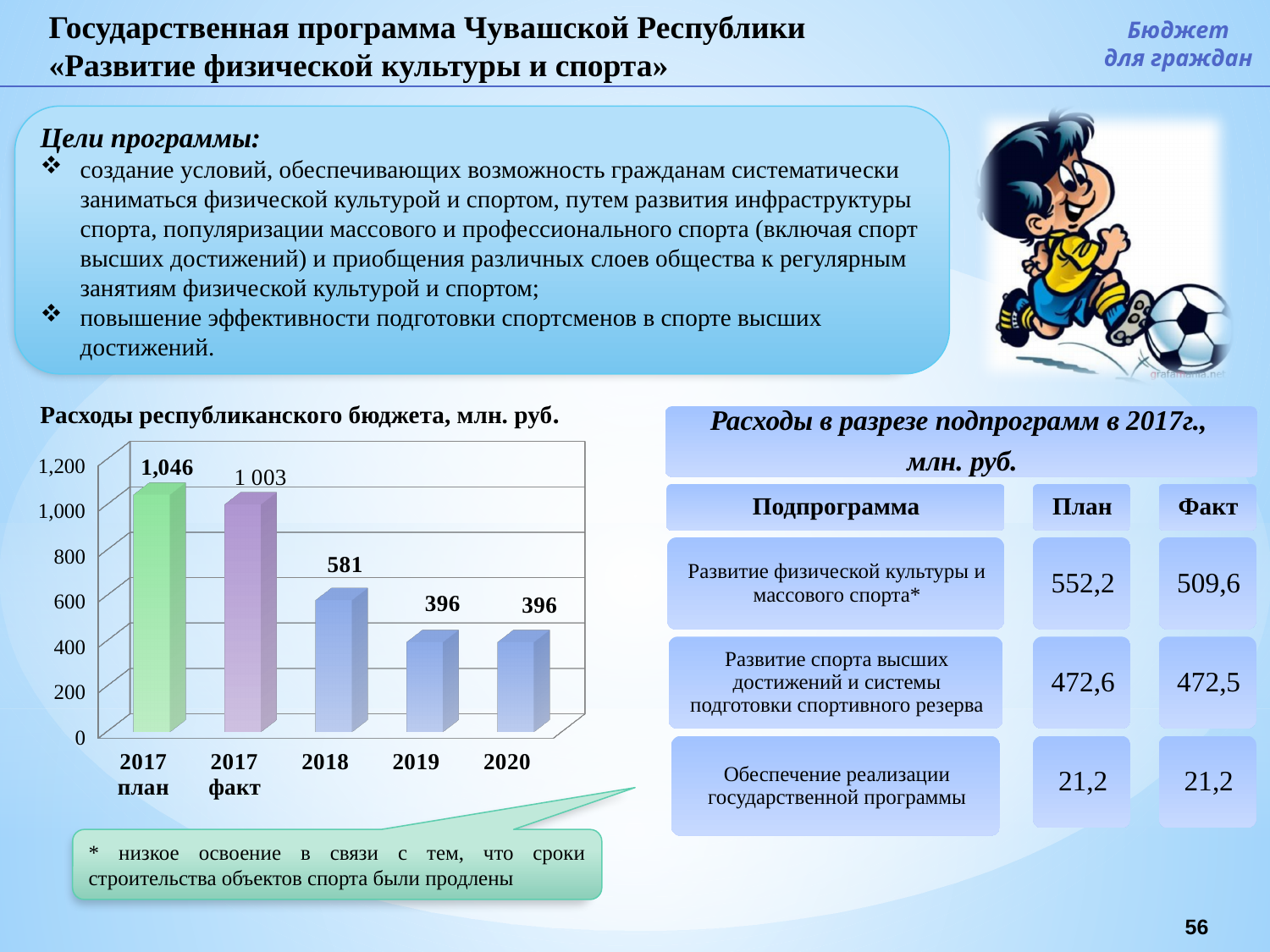
Which category has the highest value in the chart 'Расходы республиканского бюджета, млн. руб.'? 2017 план What kind of chart is 'Расходы республиканского бюджета, млн. руб.'? bar chart Do the values in the chart 'Расходы республиканского бюджета, млн. руб.' generally rise or fall from 2017 план to 2020? fall What is the value for 2018 in the chart 'Расходы республиканского бюджета, млн. руб.'? 581 In the chart 'Расходы республиканского бюджета, млн. руб.', which is larger: the value for 2018 or the value for 2019? 2018 What is the value for 2017 план in the chart 'Расходы республиканского бюджета, млн. руб.'? 1,046 What is the value for 2020 in the chart 'Расходы республиканского бюджета, млн. руб.'? 396 What is the value for 2017 факт in the chart 'Расходы республиканского бюджета, млн. руб.'? 1 003 How many categories are shown on the x axis of the chart 'Расходы республиканского бюджета, млн. руб.'? 5 What is the difference between the 2017 план and 2017 факт values in the chart 'Расходы республиканского бюджета, млн. руб.'? 43 What is the difference between the 2018 and 2019 values in the chart 'Расходы республиканского бюджета, млн. руб.'? 185 In the chart 'Расходы республиканского бюджета, млн. руб.', is the value for 2017 план greater or less than 1,000? greater